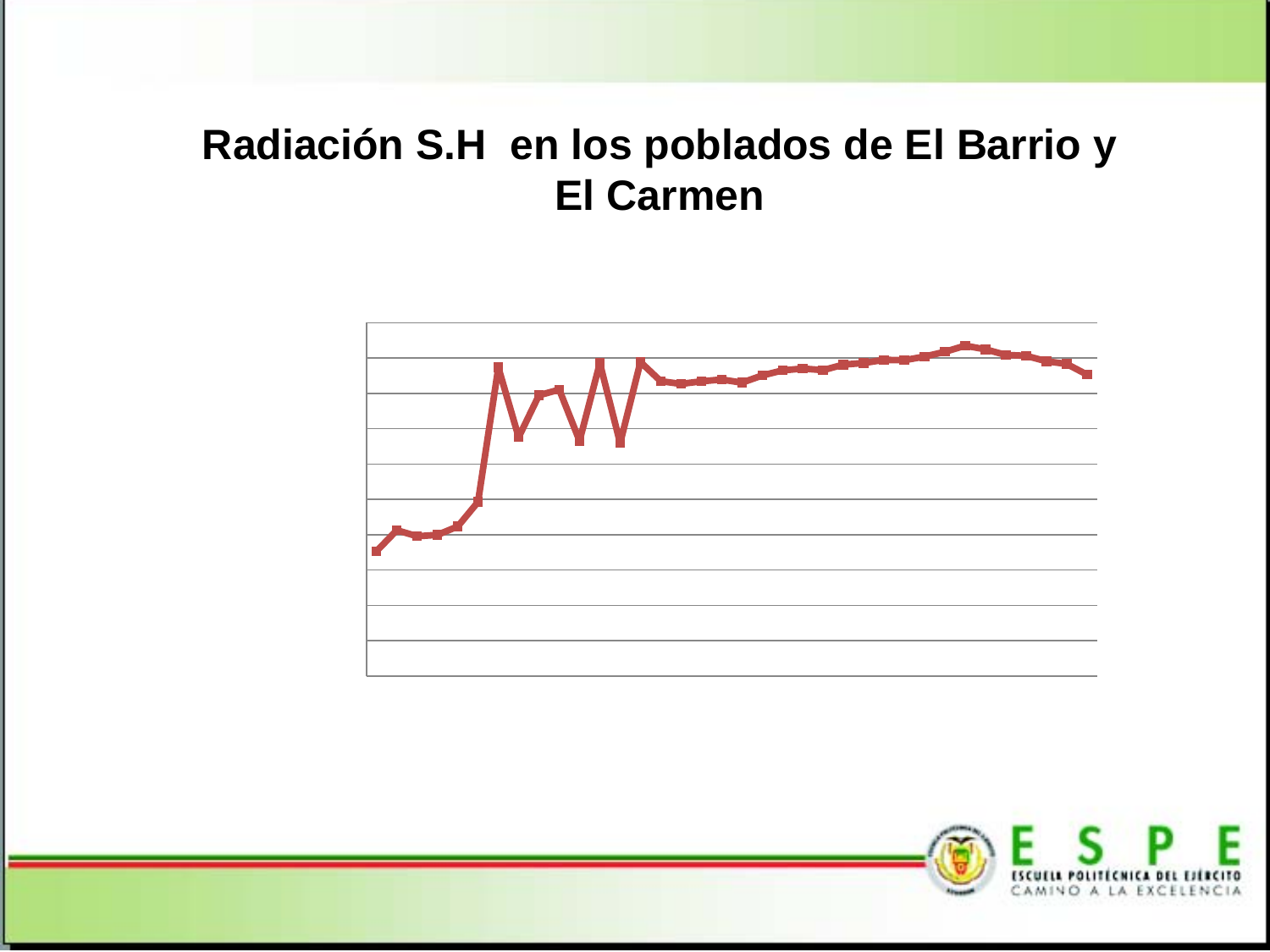
What kind of chart is shown on the slide? line chart What is the title shown above the chart on the slide? Radiación S.H en los poblados de El Barrio y El Carmen How many lines (series) are plotted on the chart? 1 What colour is the line plotted on the chart? red Do the values on the line chart generally rise or fall from left to right? rise